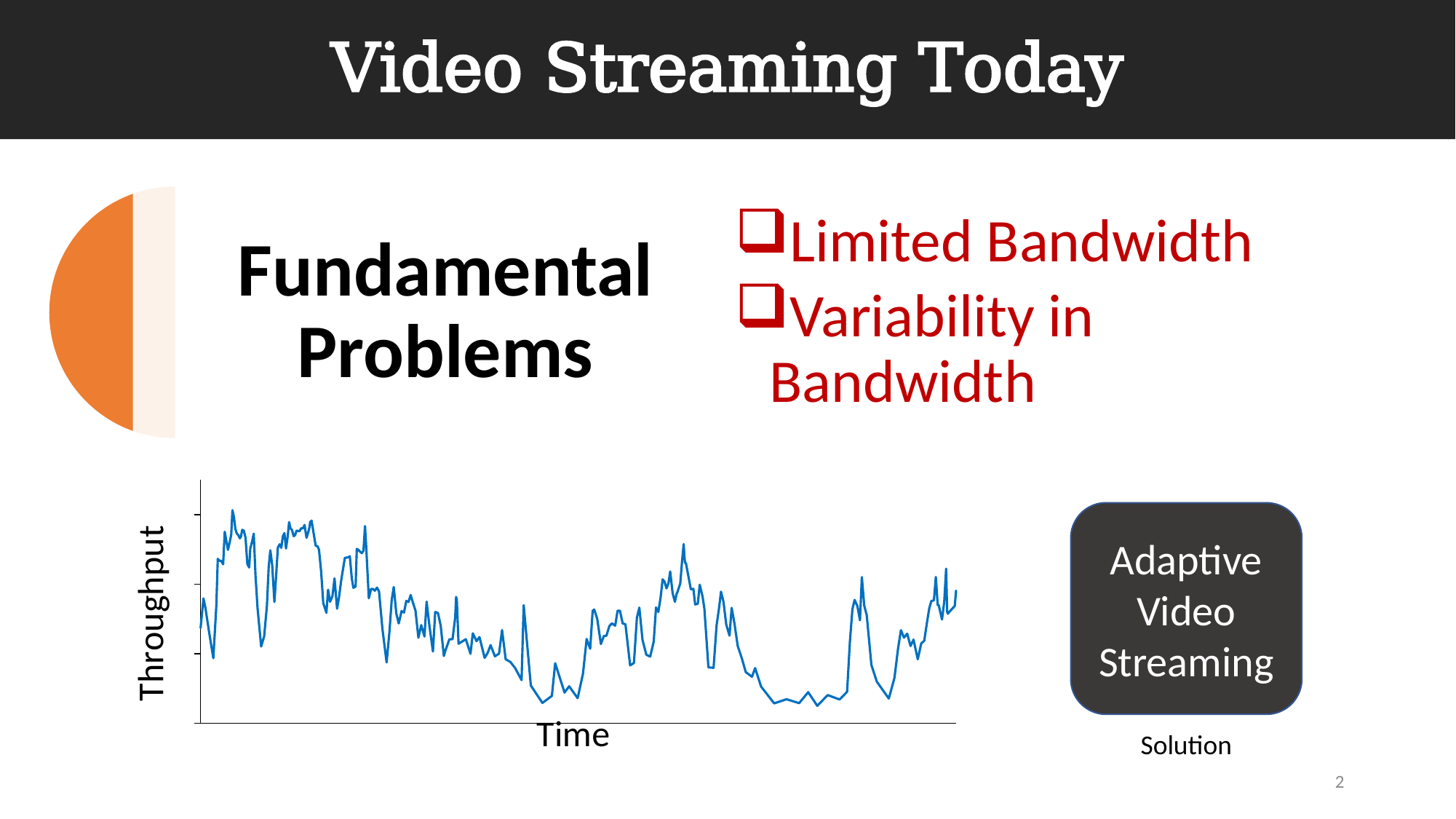
What is the label on the horizontal axis of the chart? Time What is the label on the vertical axis of the chart? Throughput What kind of chart is shown at the bottom left of the slide? line chart How many data series (lines) are plotted in the chart? 1 Does the throughput line stay roughly constant or fluctuate strongly over time? fluctuate strongly